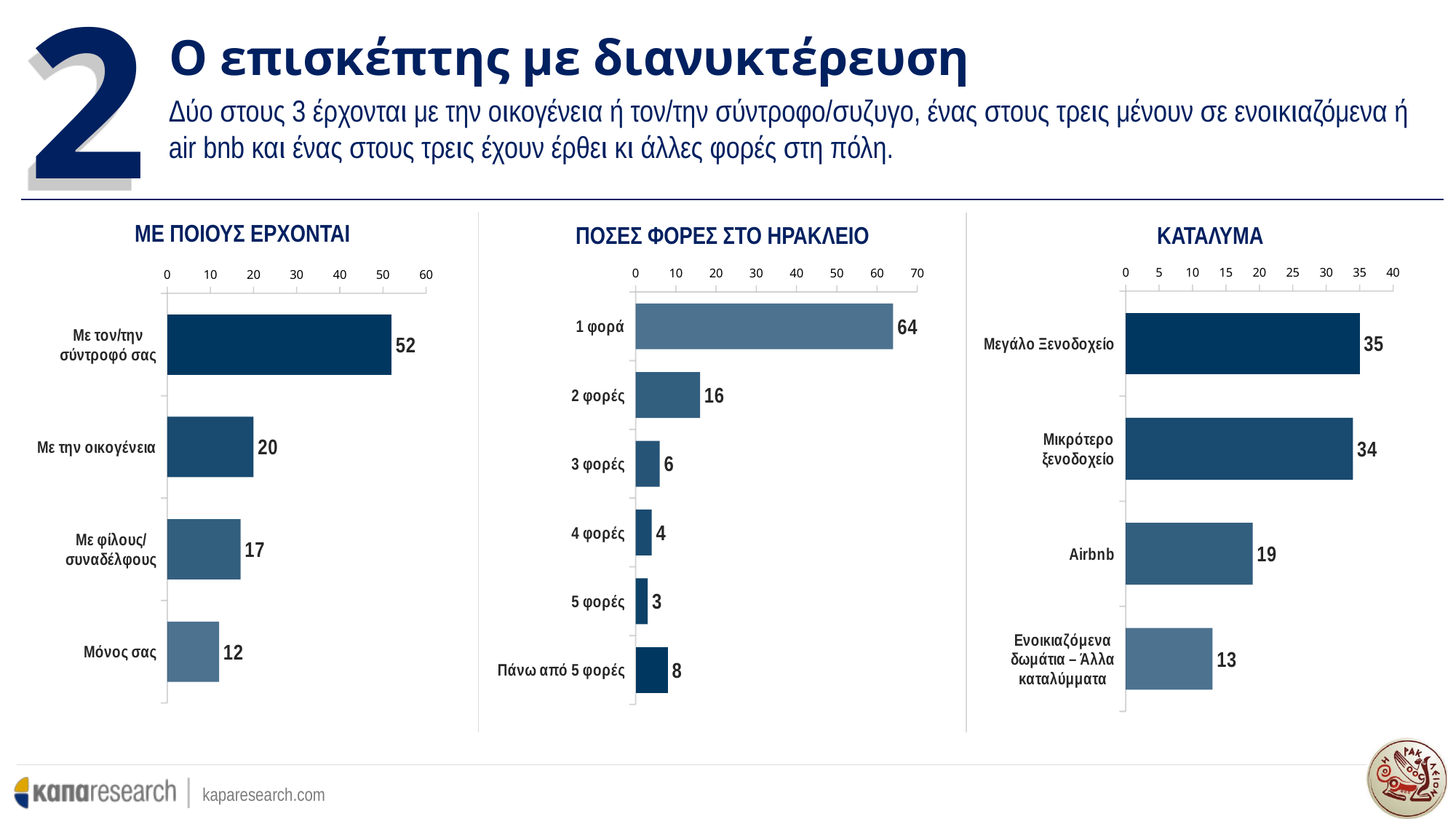
In the chart titled 'ΚΑΤΑΛΥΜΑ', what is the value for 'Airbnb'? 19 In the chart titled 'ΠΟΣΕΣ ΦΟΡΕΣ ΣΤΟ ΗΡΑΚΛΕΙΟ', how many categories are shown? 6 What type of chart is the chart titled 'ΚΑΤΑΛΥΜΑ'? Bar chart In the chart titled 'ΚΑΤΑΛΥΜΑ', what is the value for 'Ενοικιαζόμενα δωμάτια – Άλλα καταλύμματα'? 13 In the chart titled 'ΠΟΣΕΣ ΦΟΡΕΣ ΣΤΟ ΗΡΑΚΛΕΙΟ', which is larger: '2 φορές' or 'Πάνω από 5 φορές'? 2 φορές In the chart titled 'ΠΟΣΕΣ ΦΟΡΕΣ ΣΤΟ ΗΡΑΚΛΕΙΟ', what is the value for '1 φορά'? 64 In the chart titled 'ΜΕ ΠΟΙΟΥΣ ΕΡΧΟΝΤΑΙ', what is the difference between 'Με φίλους/συναδέλφους' and 'Μόνος σας'? 5 In the chart titled 'ΠΟΣΕΣ ΦΟΡΕΣ ΣΤΟ ΗΡΑΚΛΕΙΟ', which category has the lowest value? 5 φορές In the chart titled 'ΜΕ ΠΟΙΟΥΣ ΕΡΧΟΝΤΑΙ', which category has the highest value? Με τον/την σύντροφό σας In the chart titled 'ΜΕ ΠΟΙΟΥΣ ΕΡΧΟΝΤΑΙ', how many categories are shown? 4 In the chart titled 'ΚΑΤΑΛΥΜΑ', what is the difference between 'Μεγάλο Ξενοδοχείο' and 'Μικρότερο ξενοδοχείο'? 1 In the chart titled 'ΜΕ ΠΟΙΟΥΣ ΕΡΧΟΝΤΑΙ', what is the value for 'Με την οικογένεια'? 20